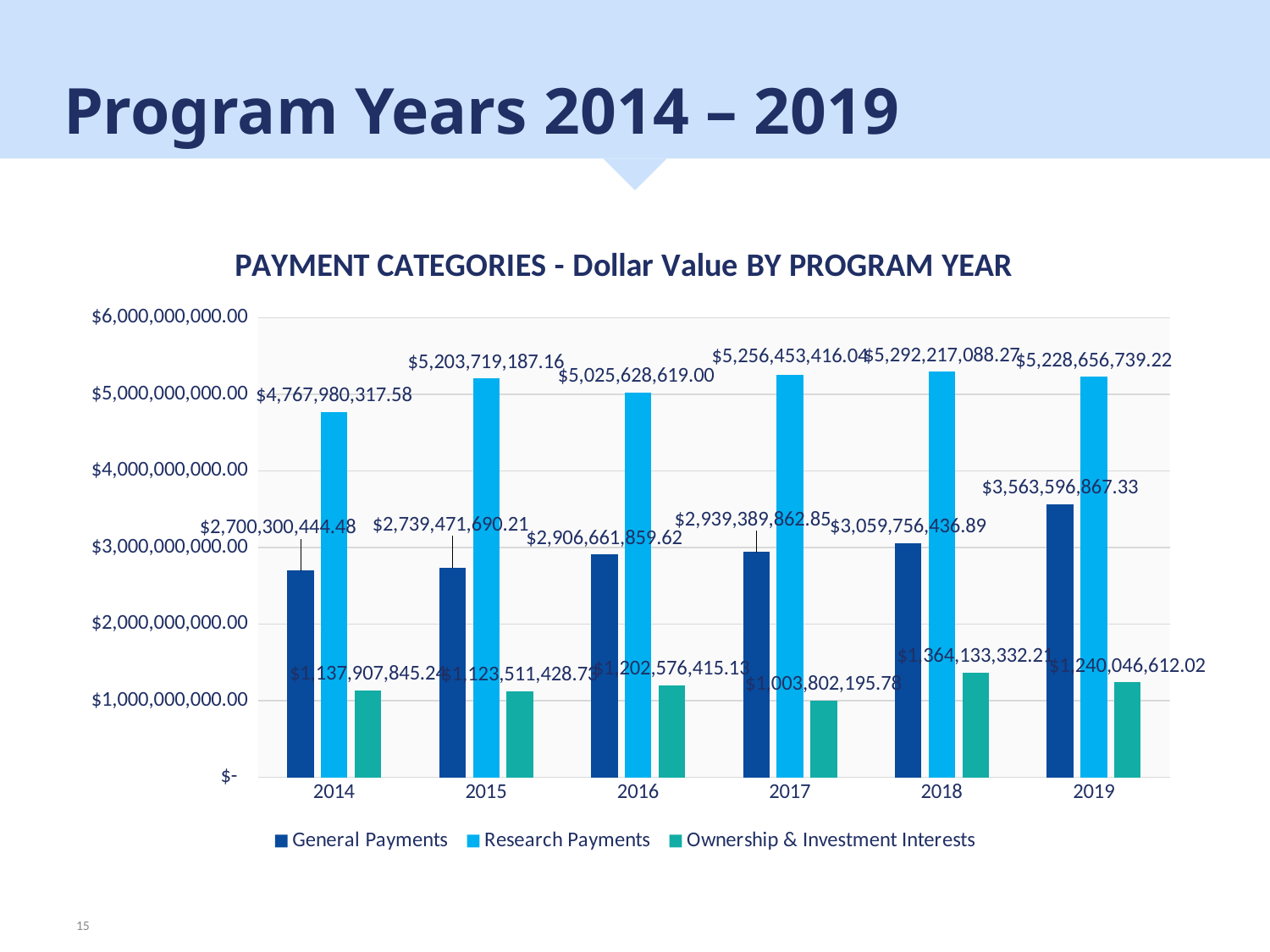
In which year are General Payments highest? 2019 Is the value of General Payments for 2014 greater or less than $3,000,000,000.00? less What is the value of Research Payments for 2018? $5,292,217,088.27 How many program years are shown on the x axis? 6 In which year are Research Payments lowest? 2014 What is the value of Ownership & Investment Interests for 2017? $1,003,802,195.78 In which year are Ownership & Investment Interests lowest? 2017 What is the difference between General Payments in 2019 and 2018? $503,840,430.44 What is the value of General Payments for 2019? $3,563,596,867.33 What kind of chart is shown on the slide? Bar chart How many series does the legend list? 3 Which year has the larger Research Payments value, 2015 or 2016? 2015